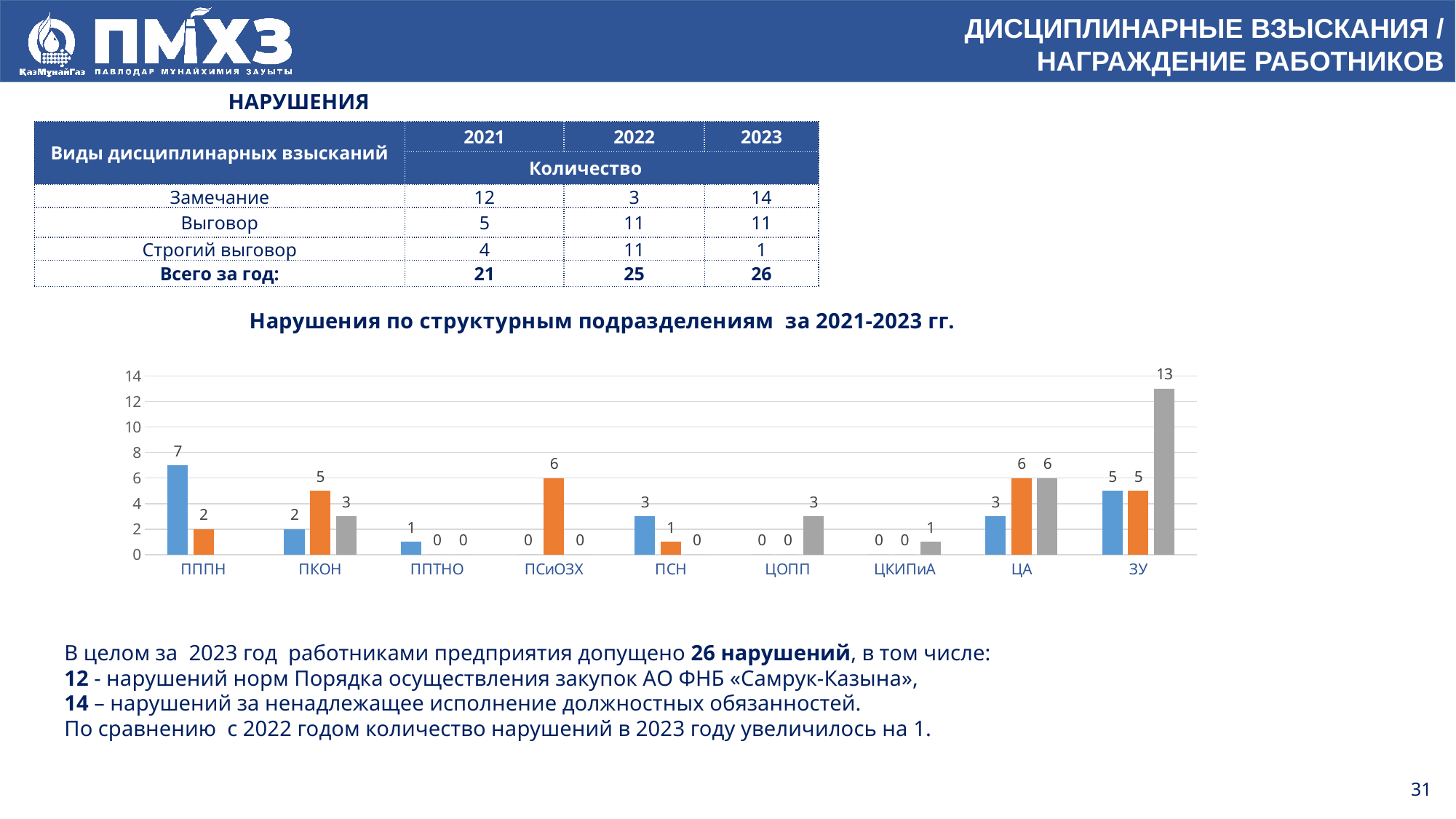
What is the value of the blue bar for ПППН? 7 What is the value of the grey bar for ЦОПП? 3 What is the value of the orange bar for ПСиОЗХ? 6 What type of chart is shown under the title 'Нарушения по структурным подразделениям за 2021-2023 гг.'? bar chart What is the highest value shown on the y axis of the chart? 14 Which category has the highest bar in the chart? ЗУ What is the total of the three bars for ЦА? 15 What is the difference between the grey bar for ЗУ and the grey bar for ЦА? 7 Which is larger: the orange bar for ПКОН or the orange bar for ПППН? ПКОН What is the value of the blue bar for ППТНО? 1 What is the value of the grey bar for ЗУ? 13 How many structural subdivisions (categories) are shown on the x axis of the chart? 9